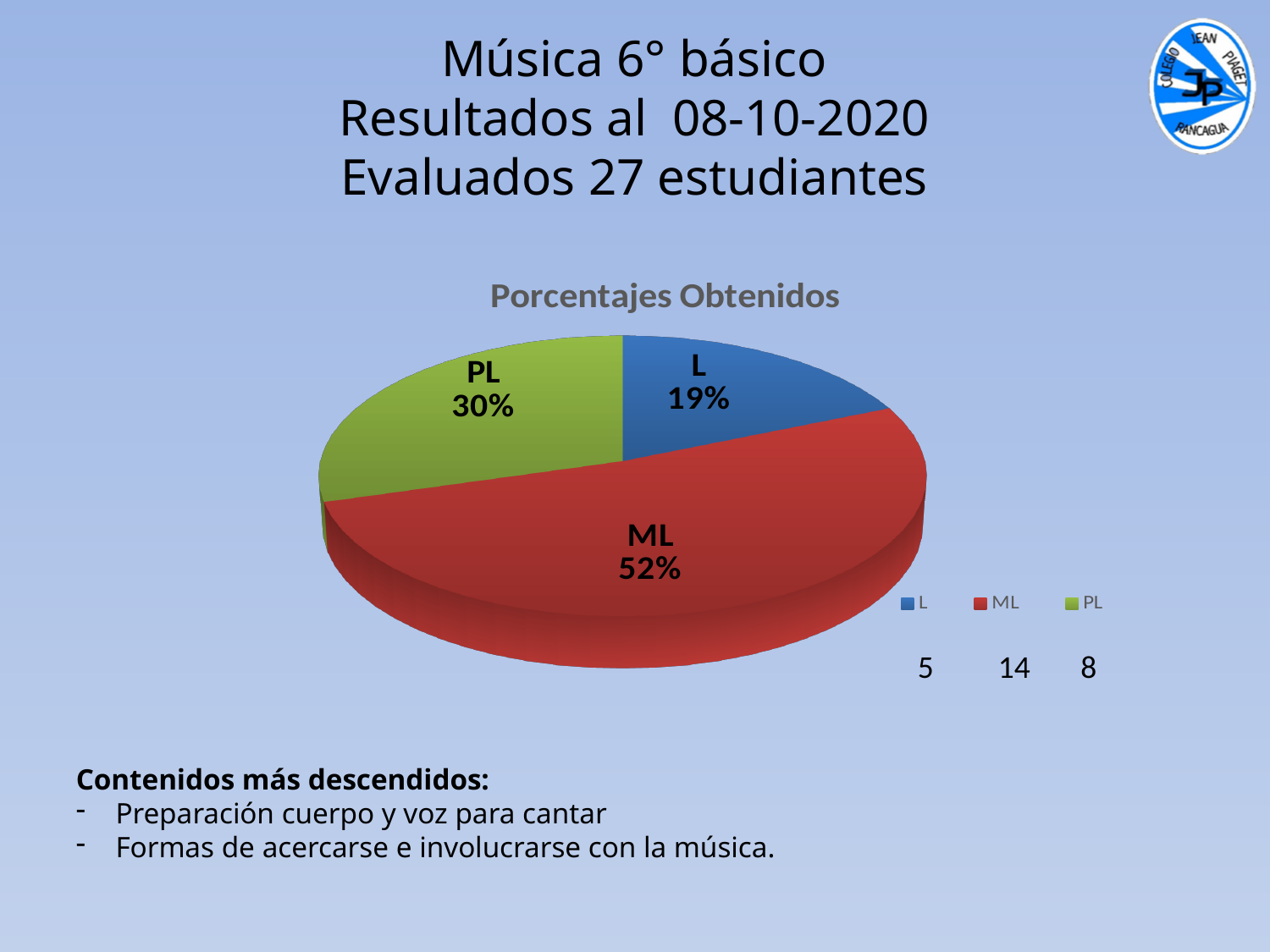
What percentage does the L slice show in the pie chart? 19% What is the difference in percentage points between the PL and L slices? 11 Which category has the largest share of the pie chart? ML What is the title of the chart? Porcentajes Obtenidos Which slice is larger, PL or L? PL What is the difference in percentage points between the ML and PL slices? 22 How many slices does the pie chart have? 3 Which category has the smallest share of the pie chart? L What kind of chart is shown on the slide? Pie chart What percentage does the ML slice show in the pie chart? 52% What percentage does the PL slice show in the pie chart? 30% How many entries does the legend list? 3